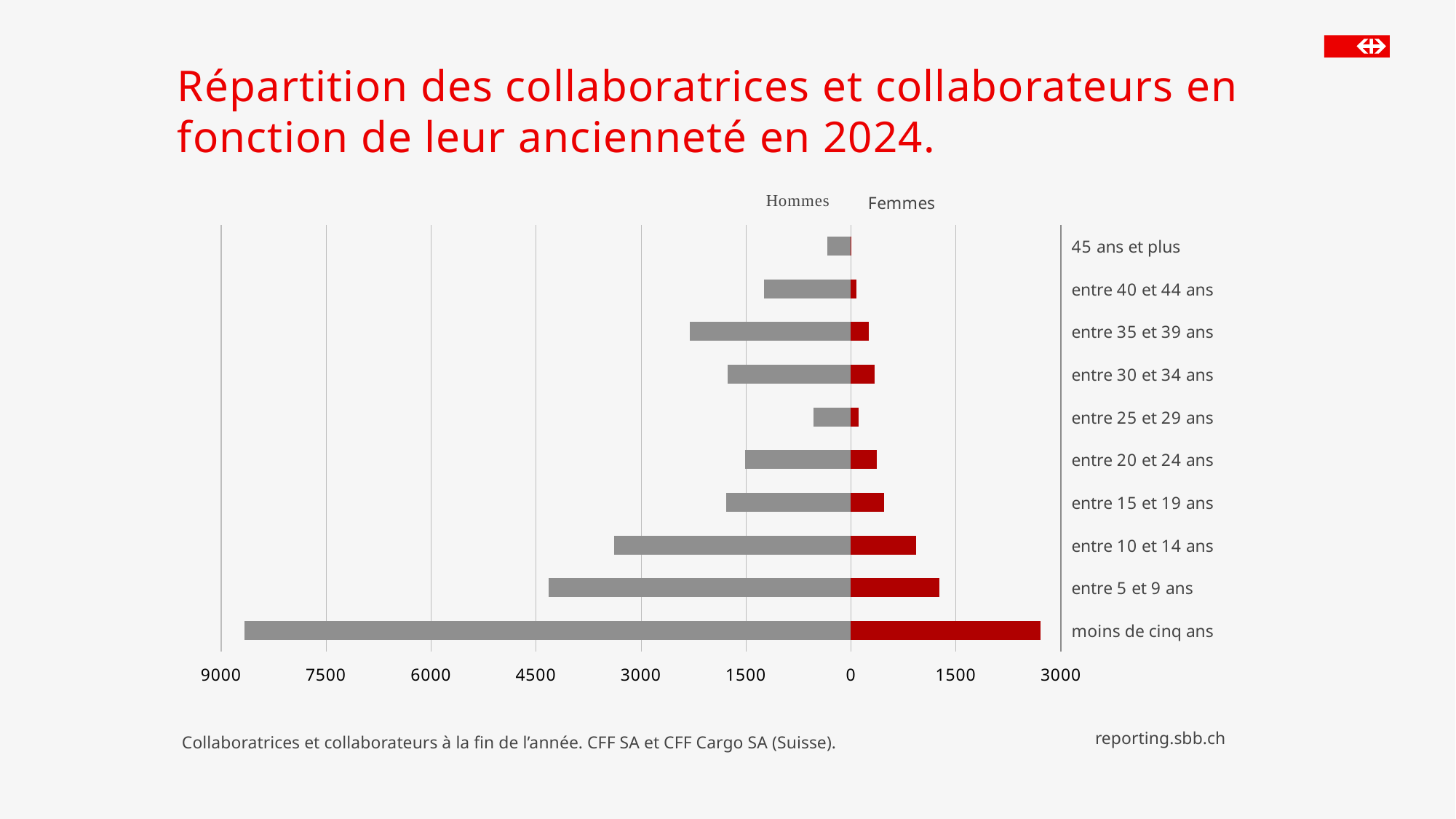
Is the Femmes value for 'moins de cinq ans' greater or less than 1500? greater For Hommes, which is larger: 'entre 5 et 9 ans' or 'entre 10 et 14 ans'? entre 5 et 9 ans How many seniority categories are shown on the chart? 10 How many series does the chart show? 2 Which seniority category has the highest value for Hommes? moins de cinq ans What kind of chart is shown on the slide? bar chart Is the Hommes value for 'entre 10 et 14 ans' greater or less than 3000? greater Which seniority category has the lowest value for Hommes? 45 ans et plus Is the Femmes value for 'entre 5 et 9 ans' greater or less than 1500? less Which seniority category has the highest value for Femmes? moins de cinq ans What colour are the Femmes bars on the chart? red